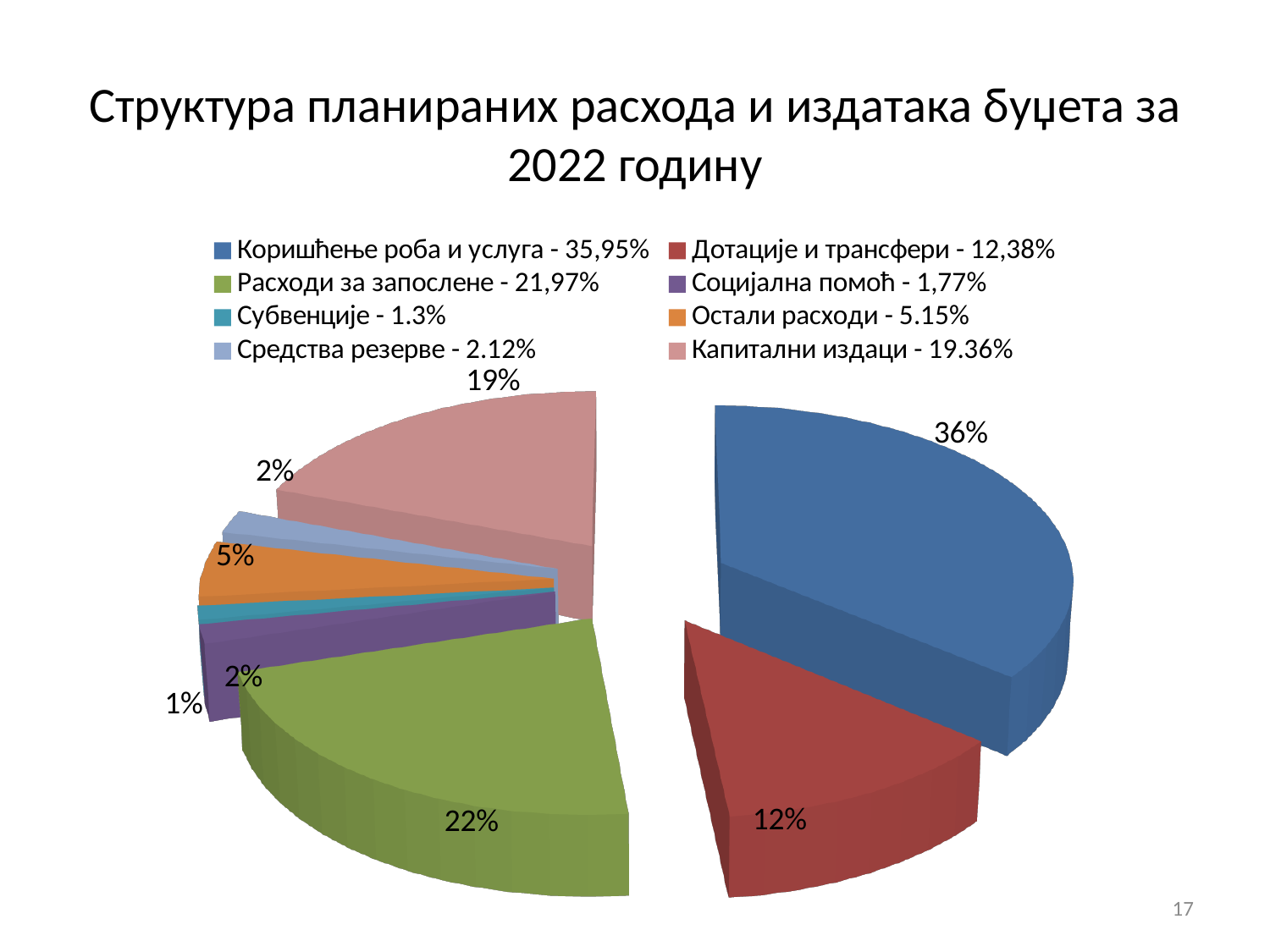
According to the data labels, what is the difference between the Коришћење роба и услуга slice and the Дотације и трансфери slice? 24% What kind of chart is shown on the slide? pie chart Which slice is larger, Расходи за запослене or Капитални издаци? Расходи за запослене Which category has the smallest slice of the pie? Субвенције What data label is shown on the slice for Капитални издаци? 19% What is the title of the slide? Структура планираних расхода и издатака буџета за 2022 годину What share of the pie does Расходи за запослене take, according to its data label? 22% Which category has the largest slice of the pie? Коришћење роба и услуга What data label is shown on the slice for Коришћење роба и услуга? 36% What percentage does the legend give for Остали расходи? 5.15% How many slices does the pie chart have? 8 What percentage does the legend give for Социјална помоћ? 1,77%